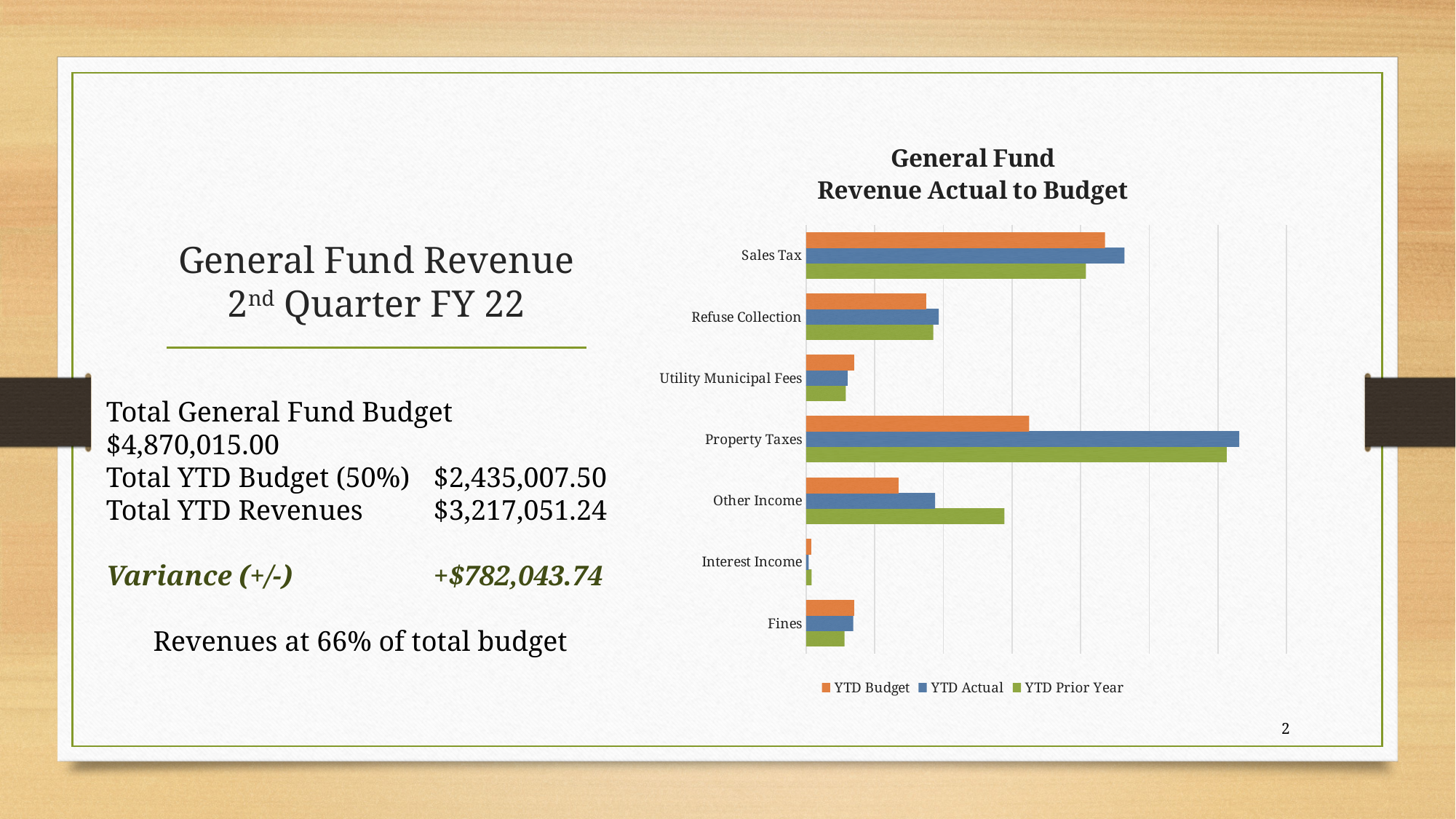
Which category has the lowest YTD Budget value? Interest Income For Other Income, which is larger: YTD Prior Year or YTD Actual? YTD Prior Year For Property Taxes, which is larger: YTD Actual or YTD Budget? YTD Actual Which colour represents the YTD Actual series in the chart? Blue How many series does the chart legend list? 3 Which category has the highest YTD Prior Year value? Property Taxes For Sales Tax, which is larger: YTD Actual or YTD Prior Year? YTD Actual How many revenue categories are shown in the chart? 7 Which category has the highest YTD Actual value? Property Taxes What kind of chart is shown on the slide? Bar chart What is the title of the chart? General Fund Revenue Actual to Budget